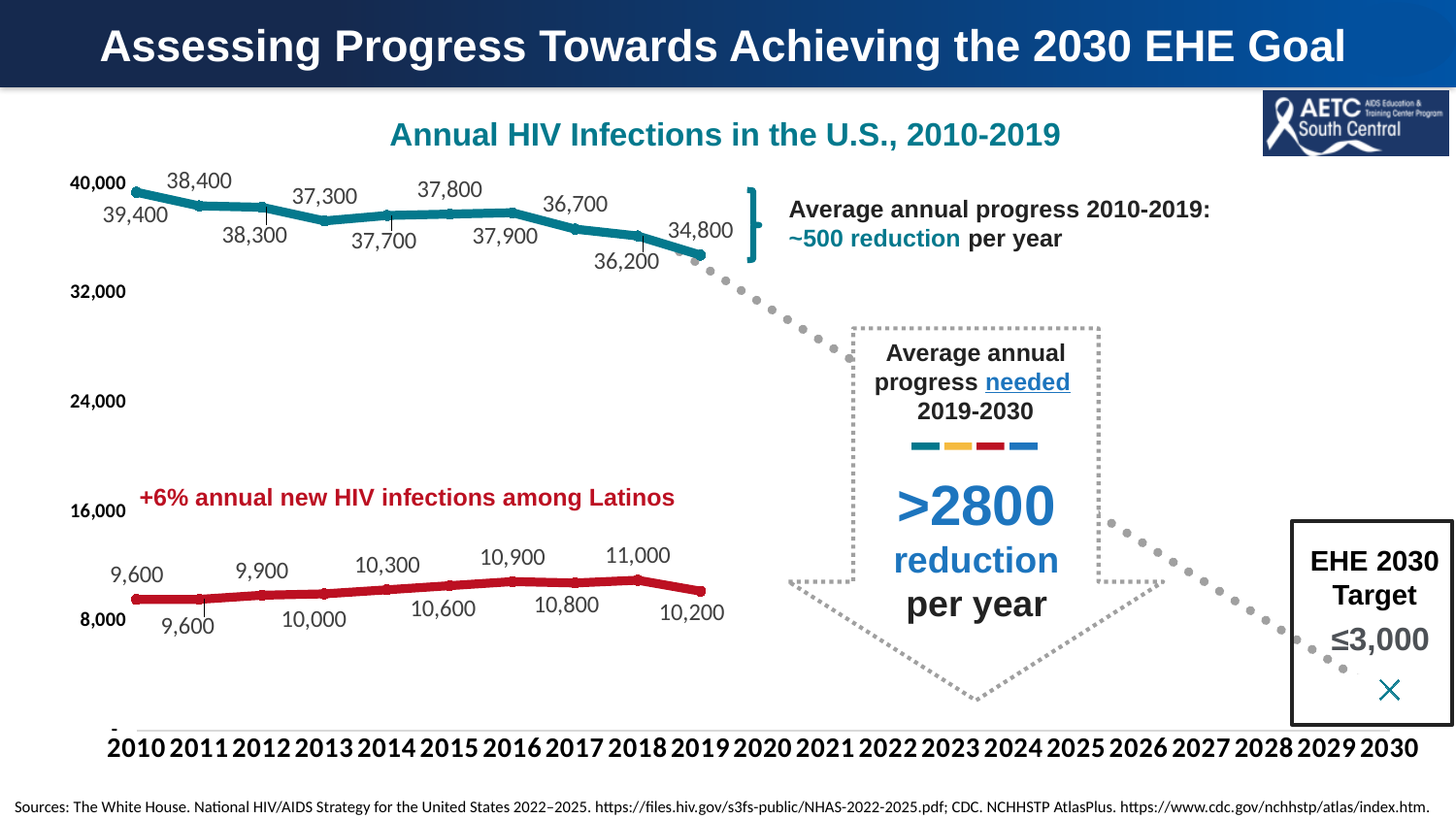
What was the number of annual HIV infections in the U.S. in 2019 according to the upper (teal) line? 34,800 How many data points are plotted on the upper (teal) line? 10 What is the EHE 2030 Target shown in the box on the right of the chart? ≤3,000 What was the number of new HIV infections among Latinos in 2018 according to the lower (red) line? 11,000 In which year was the value on the lower (red) line for HIV infections among Latinos highest? 2018 Which year has the larger value on the upper (teal) line, 2013 or 2016? 2016 By how much did total U.S. annual HIV infections (teal line) decrease from 2010 to 2019? 4,600 What was the number of annual HIV infections in the U.S. in 2010 according to the upper (teal) line? 39,400 In which year was the value on the upper (teal) line for total U.S. HIV infections highest? 2010 Does the upper (teal) line for total U.S. HIV infections generally rise or fall from 2010 to 2019? fall In which year was the value on the upper (teal) line for total U.S. HIV infections lowest? 2019 What kind of chart is shown on the slide? line chart